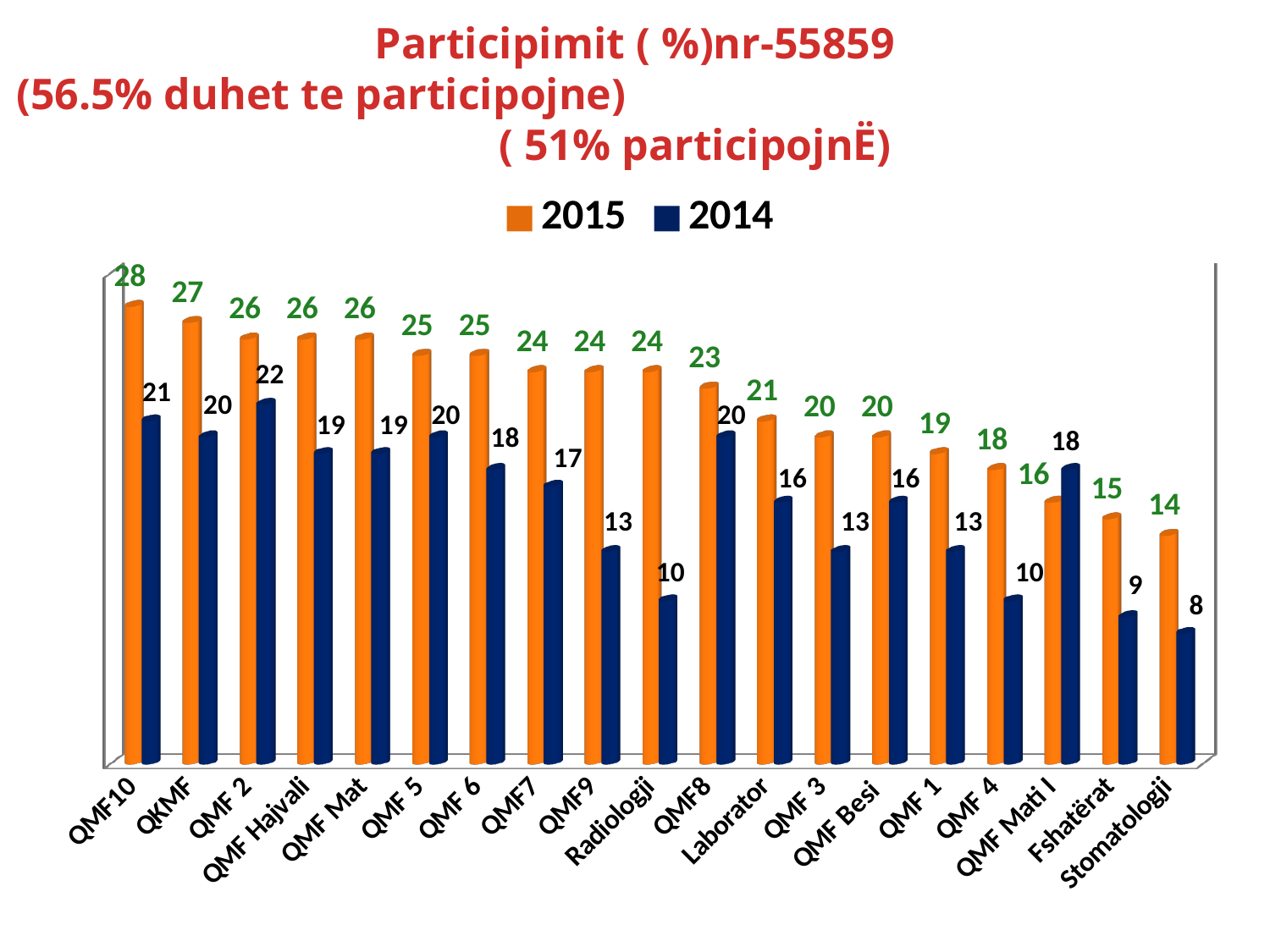
What is the 2015 value for QMF Hajvali? 26 What is the difference between the 2015 and 2014 values for QMF10? 7 Do the 2015 values rise or fall from left to right along the x axis? fall What kind of chart is shown on the slide? bar chart How many categories are shown on the x axis? 19 Which category has the highest 2014 value? QMF 2 How many series does the legend list? 2 Which category has the lowest 2014 value? Stomatologji What is the 2014 value for Radiologji? 10 What is the difference between the 2015 and 2014 values for Radiologji? 14 Which category has the highest 2015 value? QMF10 For QMF Mati I, which series has the larger value, 2015 or 2014? 2014